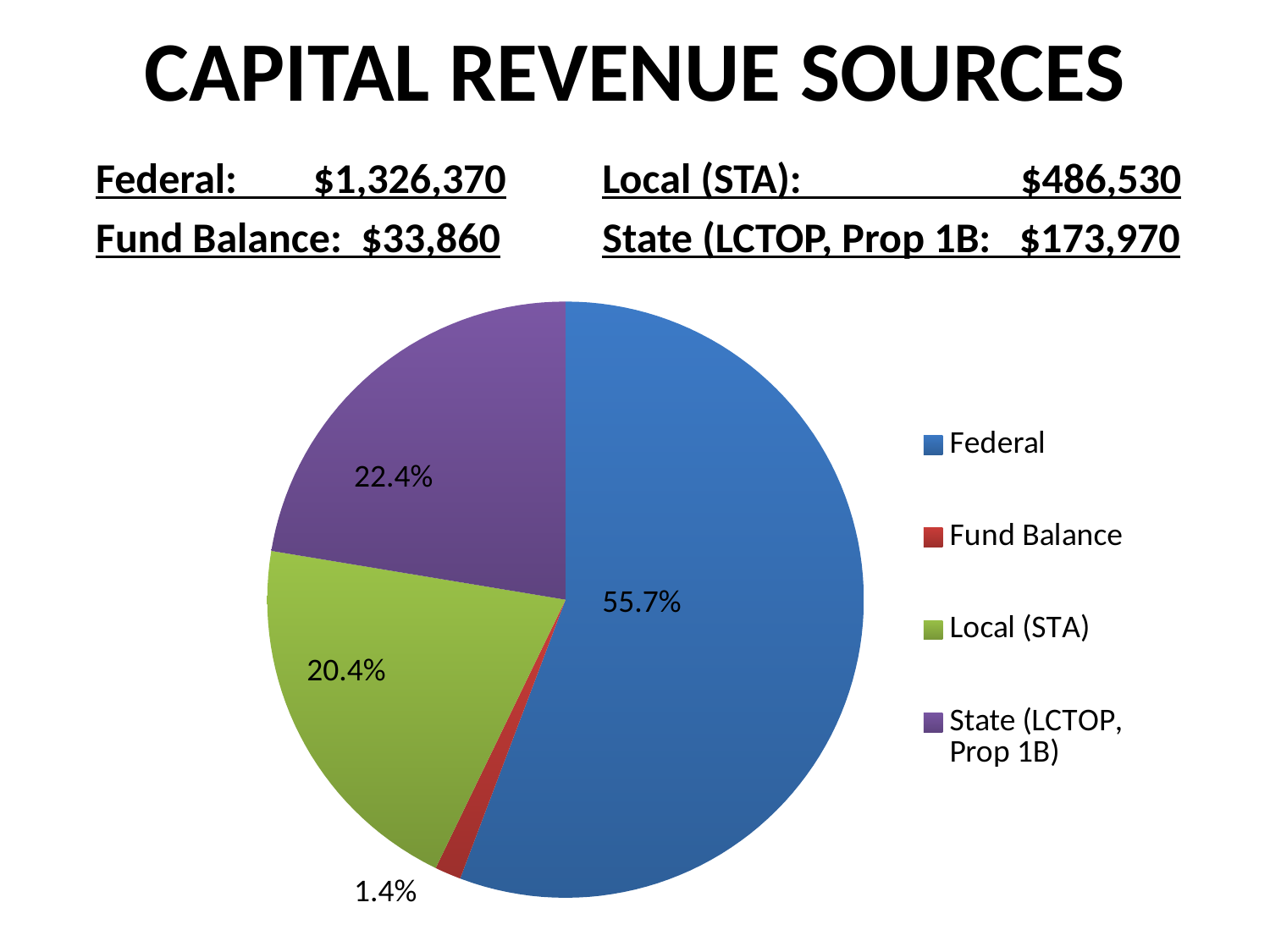
What is the difference in percentage points between the Federal slice and the State (LCTOP, Prop 1B) slice? 33.3 What share of the pie does State (LCTOP, Prop 1B) represent? 22.4% Which slice is larger, Local (STA) or State (LCTOP, Prop 1B)? State (LCTOP, Prop 1B) Which category has the smallest slice of the pie? Fund Balance What colour is the Federal slice in the pie chart? blue How many slices does the pie chart have? 4 What share of the pie does Fund Balance represent? 1.4% What kind of chart is shown on the slide? pie chart What share of the pie does Federal represent? 55.7% Which category has the largest slice of the pie? Federal What is the title of the slide containing the pie chart? CAPITAL REVENUE SOURCES